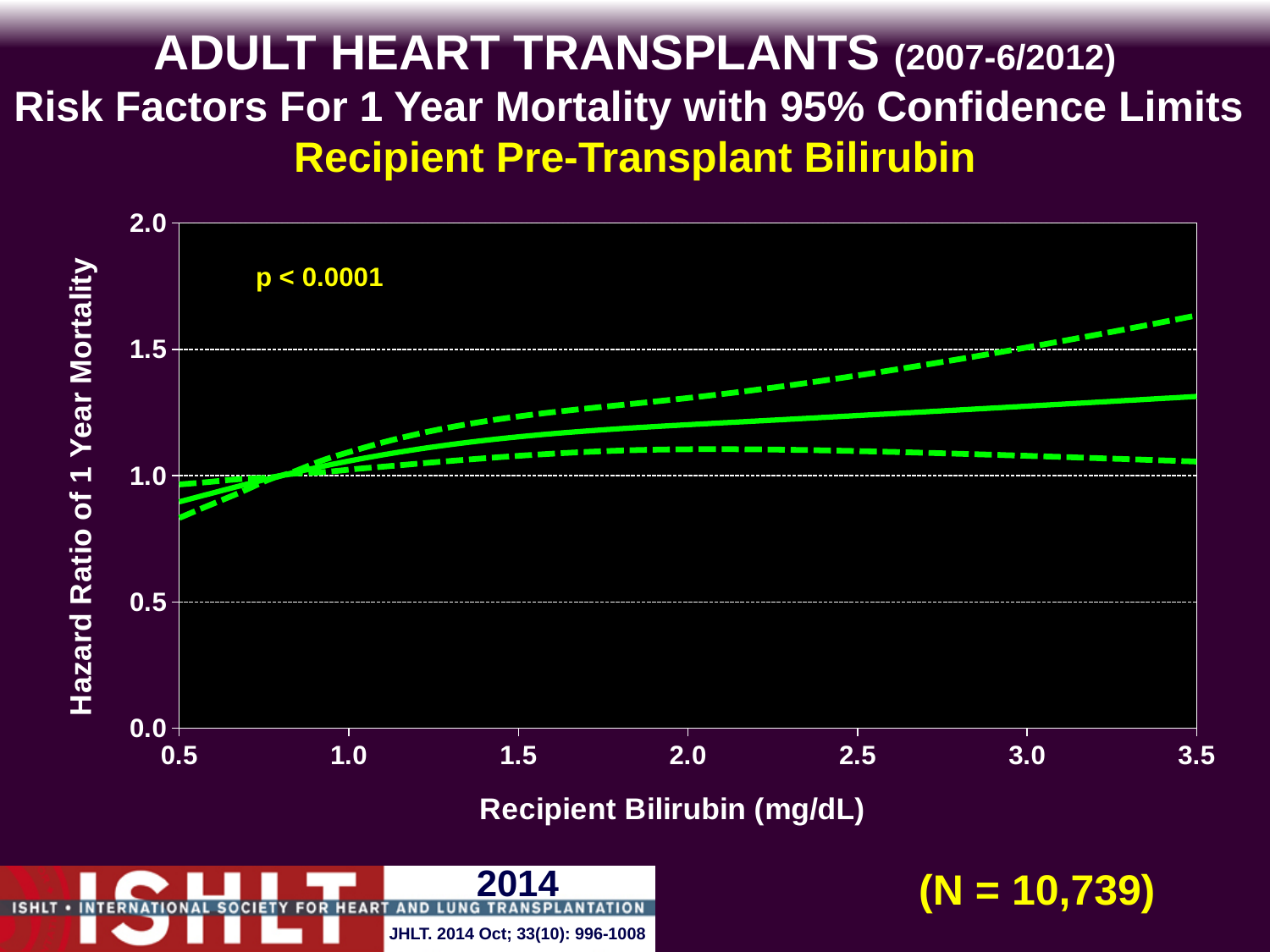
Is the hazard ratio on the solid line at a recipient bilirubin of 3.5 mg/dL greater or less than 1.5? less Is the hazard ratio on the solid line at a recipient bilirubin of 0.5 mg/dL greater or less than 1.0? less Is the lower dashed confidence limit at a recipient bilirubin of 3.5 mg/dL greater or less than 1.5? less Does the solid hazard ratio line rise or fall as recipient bilirubin increases from 0.5 to 3.5 mg/dL? rise What is the label of the x axis? Recipient Bilirubin (mg/dL) What p-value is printed on the chart? p < 0.0001 How many lines are plotted on the chart? 3 What kind of chart is shown on the slide? line chart